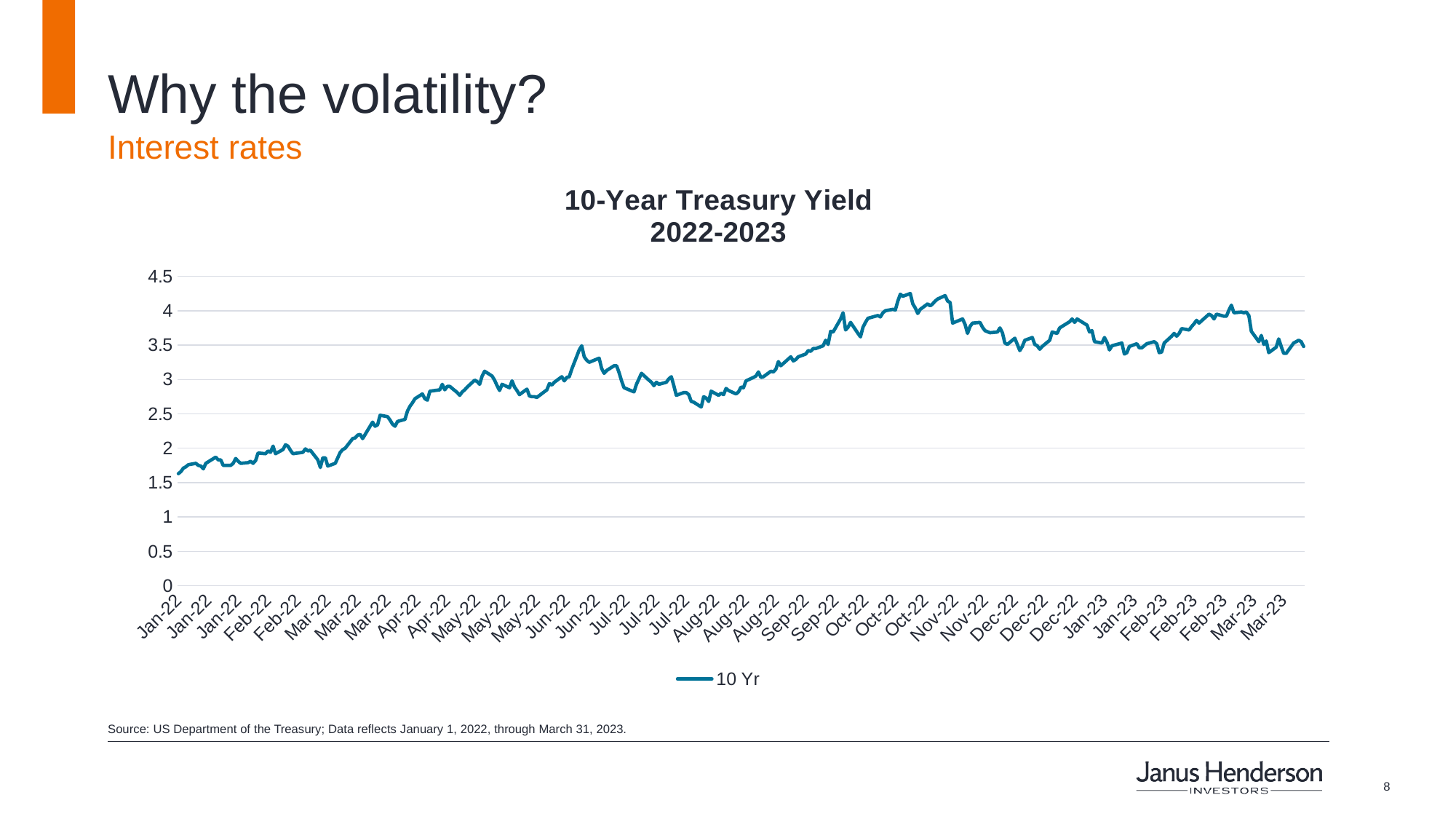
What is the title of the chart? 10-Year Treasury Yield 2022-2023 Is the value for the 10 Yr series at the end of Mar-23 greater or less than 3? greater Does the 10-year Treasury yield rise or fall overall from Jan-22 to Mar-23? rise Is the peak value for the 10 Yr series in Oct-22 greater or less than 4? greater What label does the legend give the plotted series? 10 Yr How many series does the legend list? 1 Is the value for the 10 Yr series at the end of Mar-23 greater or less than 4? less In which month does the 10 Yr series reach its highest value? Oct-22 What kind of chart is shown on the slide? line chart In which month does the 10 Yr series reach its lowest value? Jan-22